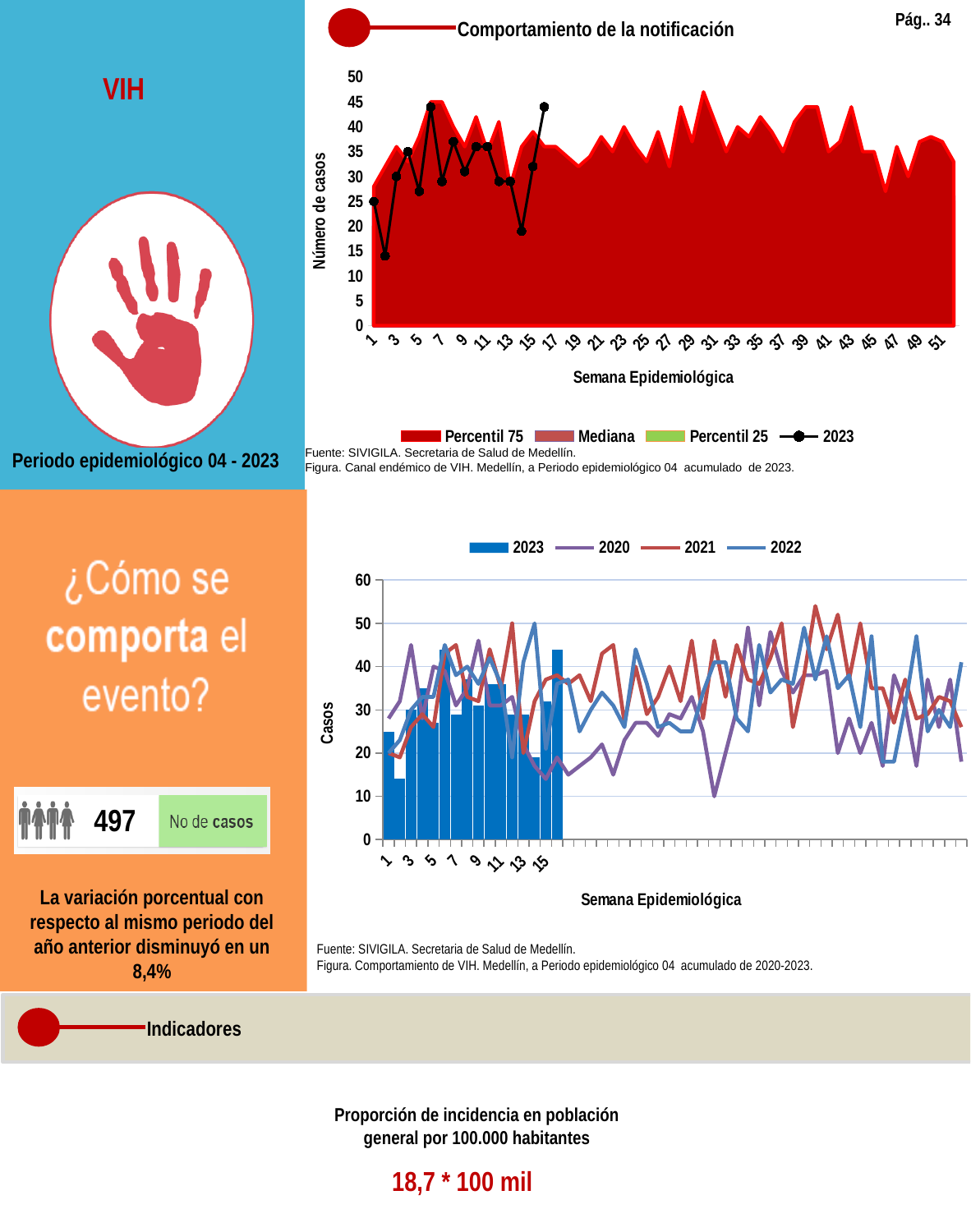
In the bottom chart, how many bars are plotted for the 2023 series? 16 In the bottom chart, which series is drawn as bars rather than lines? 2023 In the top chart, is the 2023 value for week 2 greater or less than 20? less In the top chart, is the 2023 value for week 16 greater or less than 40? greater In the top chart, which week has the lowest value on the 2023 line? Week 2 In the top chart (Comportamiento de la notificación), how many series does the legend list? 4 In the top chart, is the 2023 value for week 6 greater or less than 40? greater In the bottom chart, which week has the lowest 2023 bar? Week 2 In the bottom chart, how many series does the legend list? 4 In the top chart, what is the title of the vertical axis? Número de casos In the bottom chart, which is larger for 2023: the bar for week 2 or the bar for week 16? Week 16